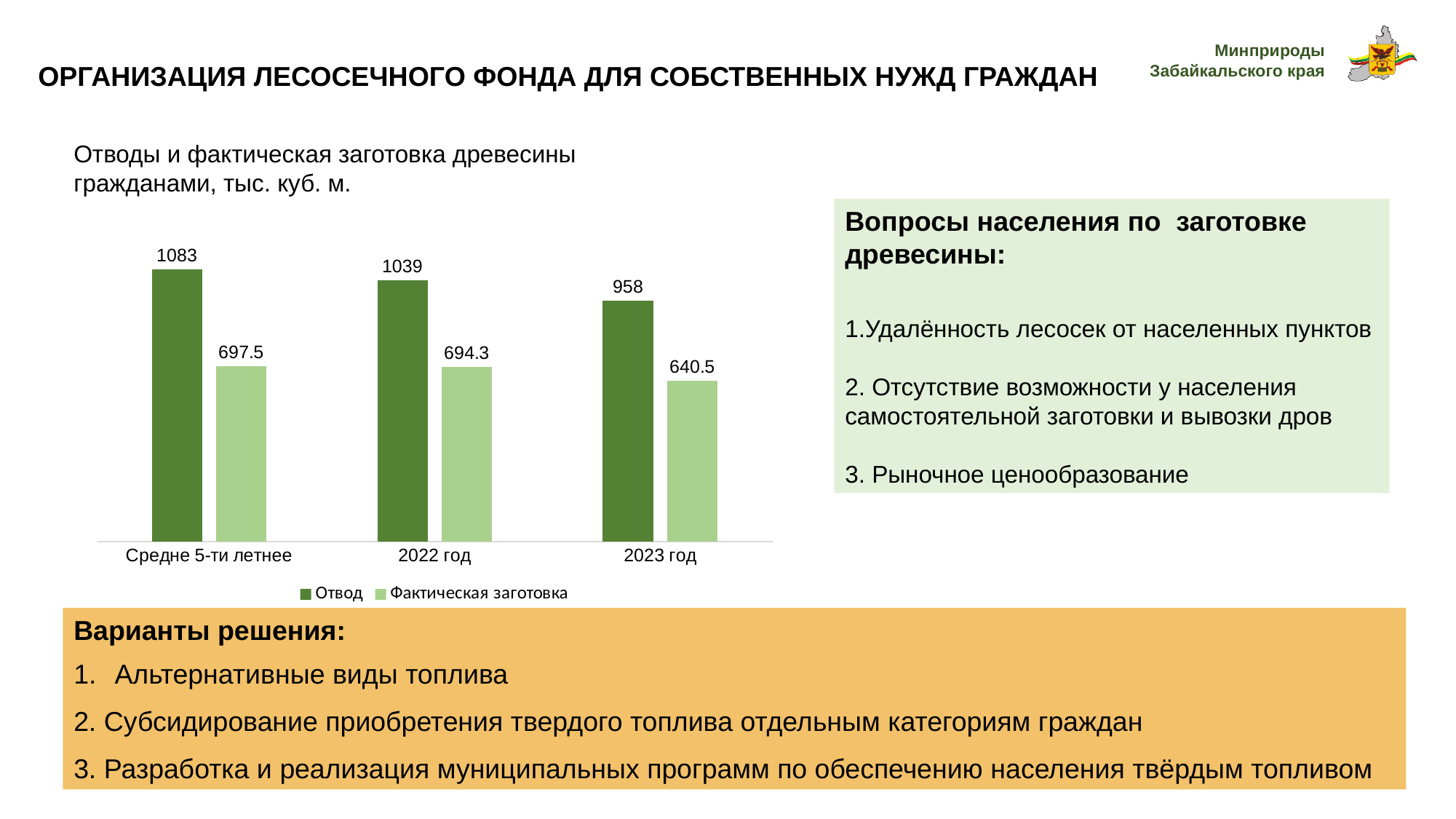
What is the value of Фактическая заготовка for Средне 5-ти летнее? 697.5 Which category has the highest Отвод value? Средне 5-ти летнее Does the Отвод value rise or fall from Средне 5-ти летнее to 2023 год? Falls Which category has the lowest Фактическая заготовка value? 2023 год What is the value of Отвод for 2023 год? 958 What is the difference between Отвод and Фактическая заготовка for 2023 год? 317.5 What is the difference between the Отвод values for Средне 5-ти летнее and 2022 год? 44 What is the value of Фактическая заготовка for 2022 год? 694.3 Which is larger: Фактическая заготовка for 2022 год or for 2023 год? 2022 год How many categories are shown on the x axis? 3 What kind of chart is shown on the slide? Bar chart How many series does the legend list? 2